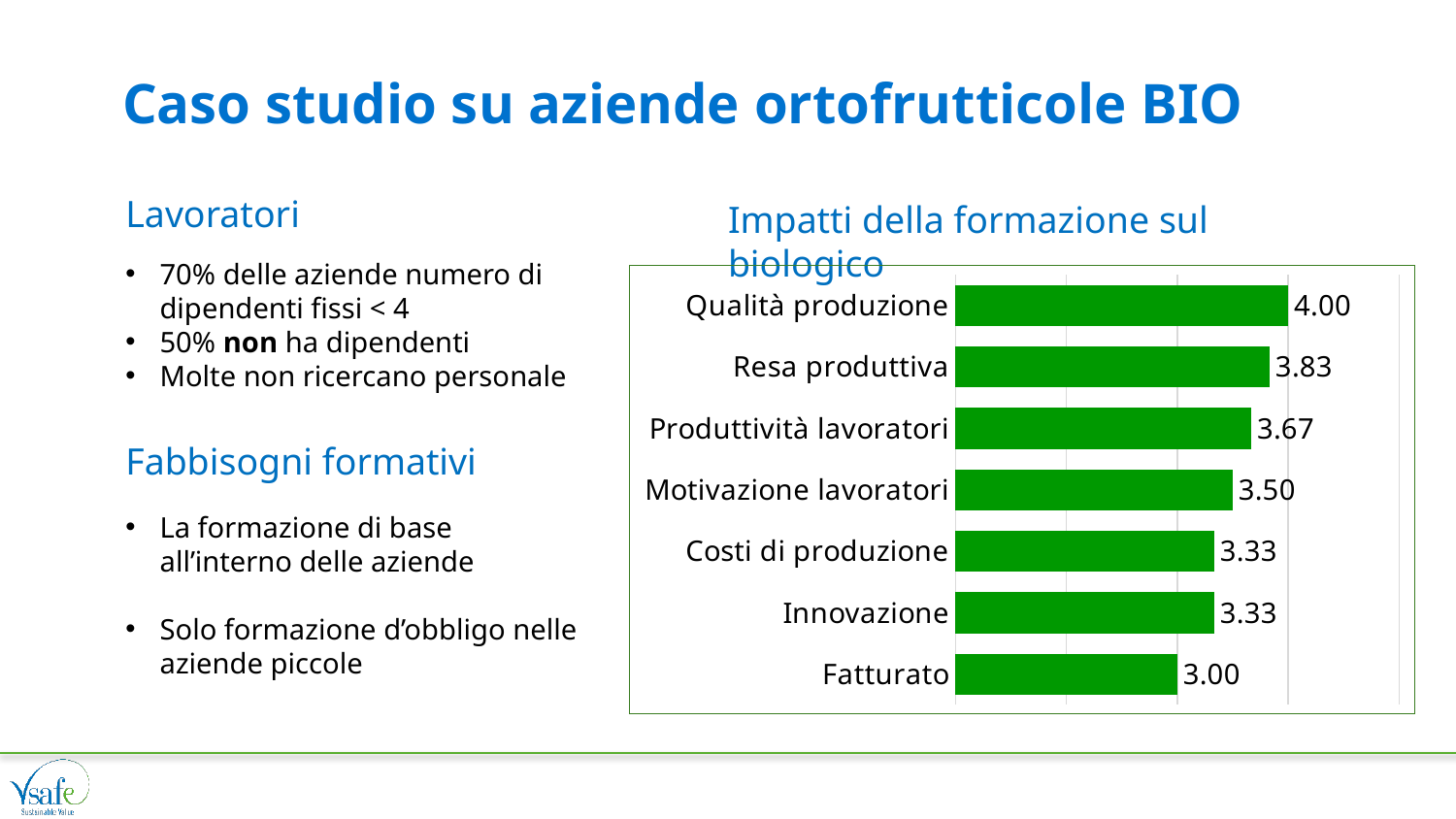
How many categories are shown in the chart? 7 What is the value for Fatturato? 3.00 What is the title of the chart? Impatti della formazione sul biologico What kind of chart is shown on the slide? Bar chart What is the difference between the values for Qualità produzione and Fatturato? 1.00 What is the difference between the values for Resa produttiva and Produttività lavoratori? 0.16 Which category has the lowest value? Fatturato Which category has the highest value? Qualità produzione What is the value for Motivazione lavoratori? 3.50 Which is larger, the value for Produttività lavoratori or the value for Costi di produzione? Produttività lavoratori What is the value for Qualità produzione? 4.00 What is the value for Resa produttiva? 3.83